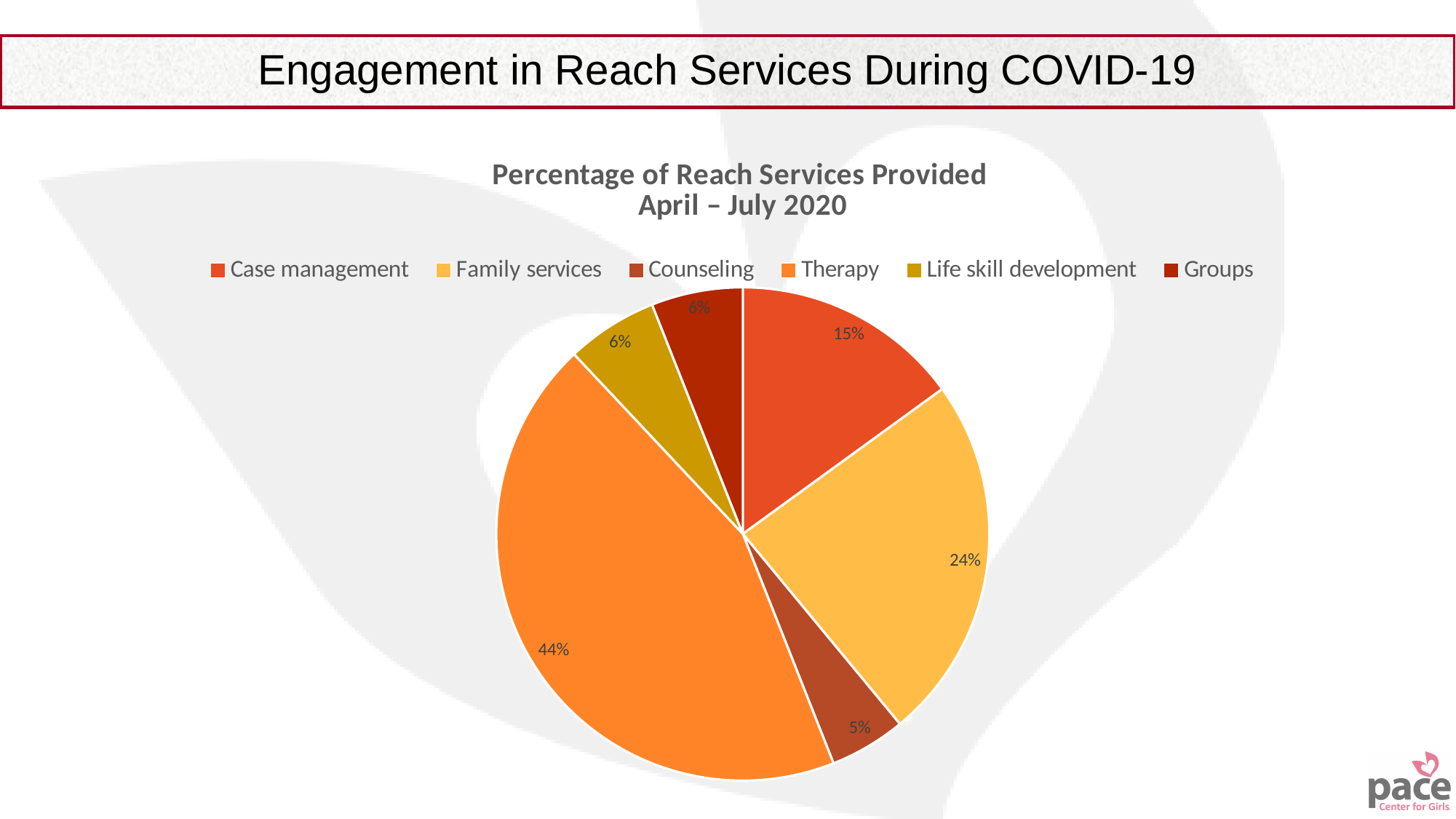
What kind of chart is shown on the slide? Pie chart What percentage of Reach services provided was Therapy? 44% How many service categories are shown in the pie chart? 6 What is the combined share of Life skill development and Groups? 12% What is the title of the chart? Percentage of Reach Services Provided April – July 2020 What percentage of Reach services provided was Case management? 15% What percentage of Reach services provided was Family services? 24% What percentage of Reach services provided was Counseling? 5% Which has a larger share, Case management or Family services? Family services Which service category has the smallest share of the pie? Counseling What is the difference in percentage points between Therapy and Family services? 20 Which service category has the largest share of the pie? Therapy